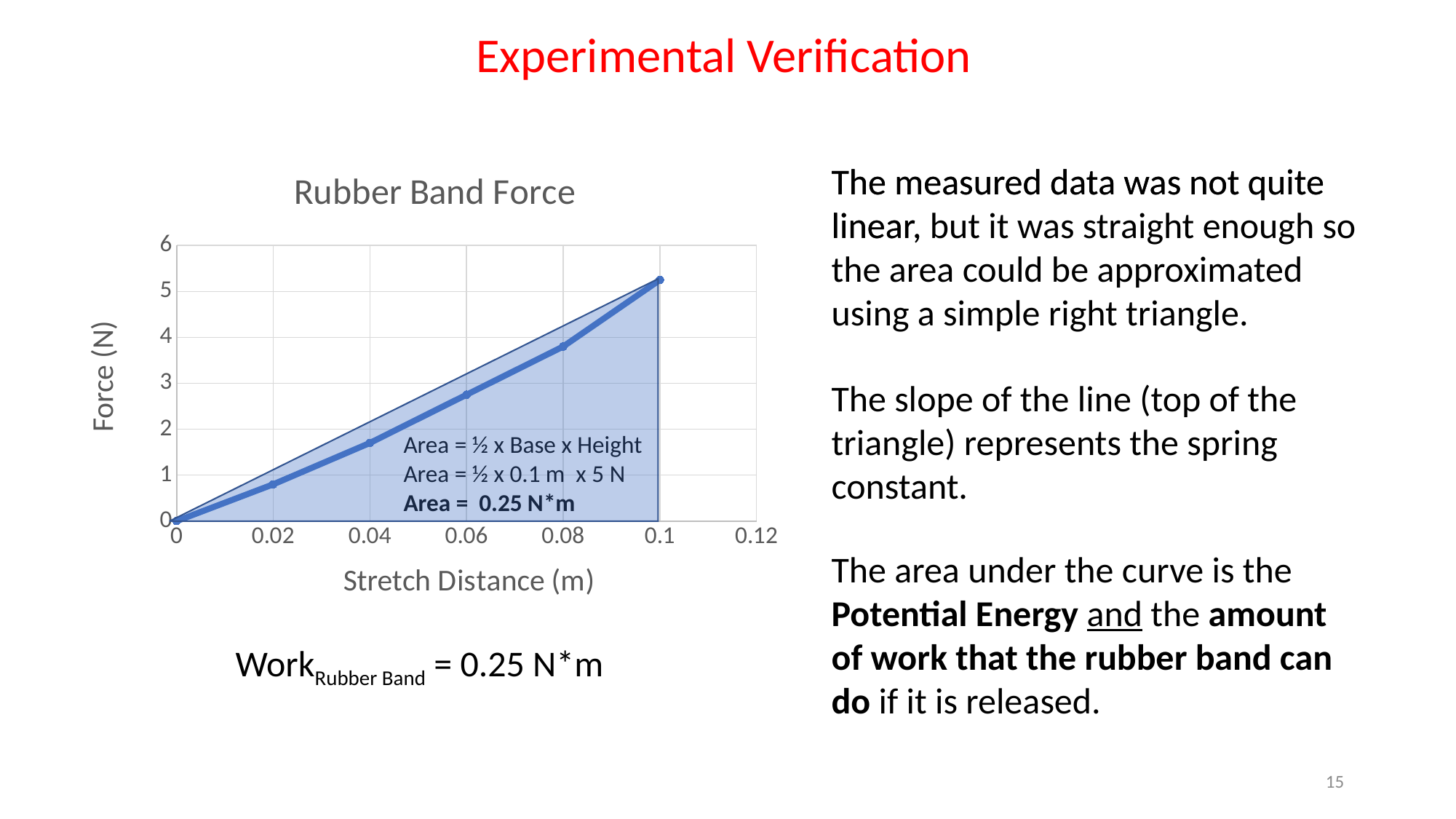
Is the force at a stretch distance of 0.08 m greater or less than 3? greater Is the force at a stretch distance of 0.1 m greater or less than 5? greater How many data points are plotted on the Rubber Band Force line? 6 Does the force rise or fall as the stretch distance increases? rise Which is larger, the force at 0.04 m or the force at 0.08 m? 0.08 m At which stretch distance is the force lowest? 0 Is the force at a stretch distance of 0.02 m greater or less than 1? less What is the title of the chart? Rubber Band Force At which stretch distance is the force highest? 0.1 What is the label of the x axis of the chart? Stretch Distance (m) What kind of chart is shown on the slide? line chart